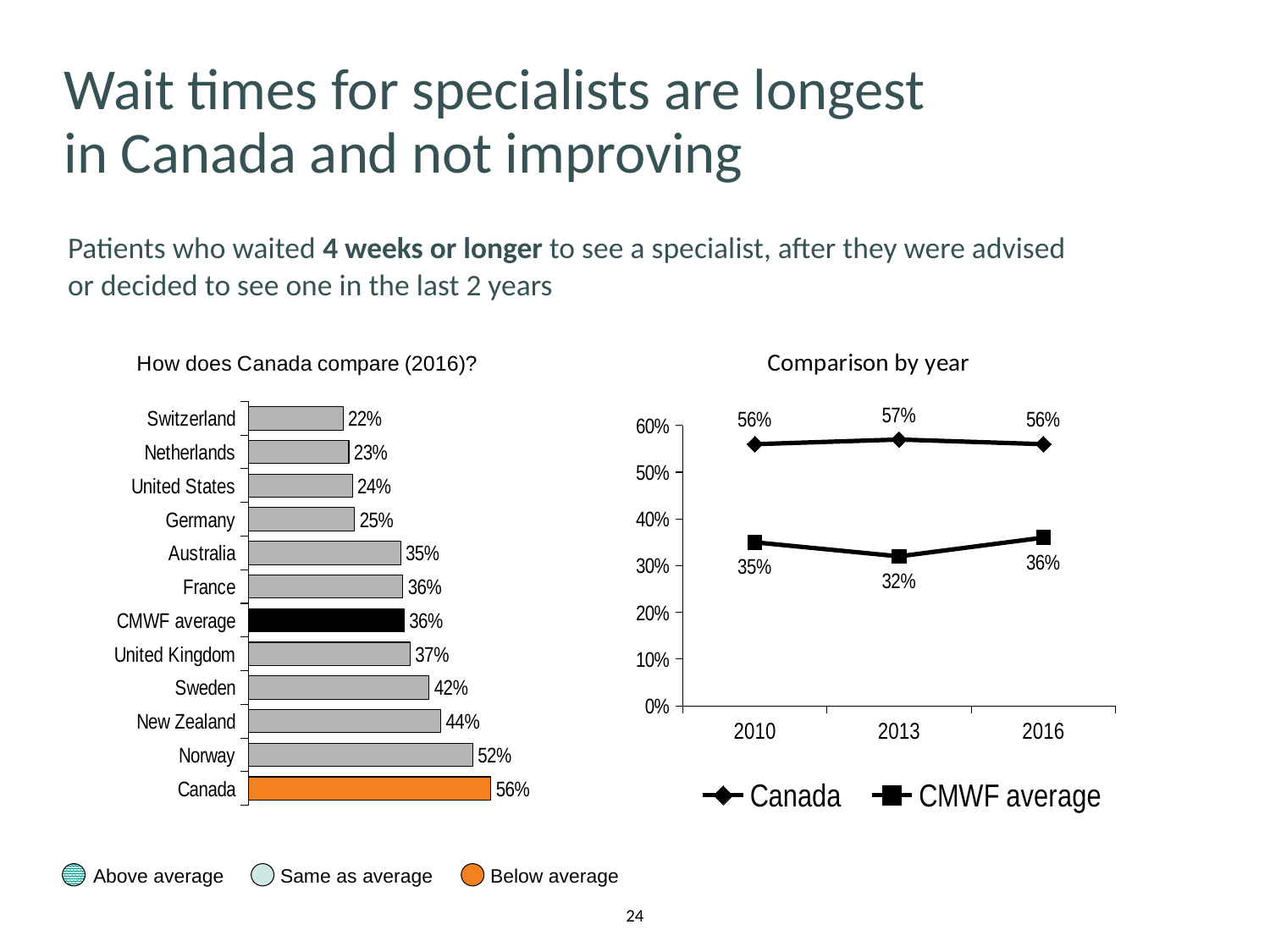
What type of chart is 'How does Canada compare (2016)?' Bar chart In the 'How does Canada compare (2016)?' chart, which country has the highest value? Canada In the 'How does Canada compare (2016)?' chart, what is the value for Norway? 52% How many bars are shown in the 'How does Canada compare (2016)?' chart? 12 In the 'How does Canada compare (2016)?' chart, which is larger, the value for Sweden or the value for Australia? Sweden How many series does the legend of the 'Comparison by year' chart list? 2 In the 'Comparison by year' chart, what is the difference between Canada and the CMWF average in 2010? 21 percentage points In the 'How does Canada compare (2016)?' chart, which country has the lowest value? Switzerland In the 'Comparison by year' chart, what is the value for Canada in 2013? 57% In the 'Comparison by year' chart, what is the value for the CMWF average in 2013? 32% In the 'How does Canada compare (2016)?' chart, what is the difference between Canada and the CMWF average? 20 percentage points In the 'How does Canada compare (2016)?' chart, what colour is the bar for Canada? Orange